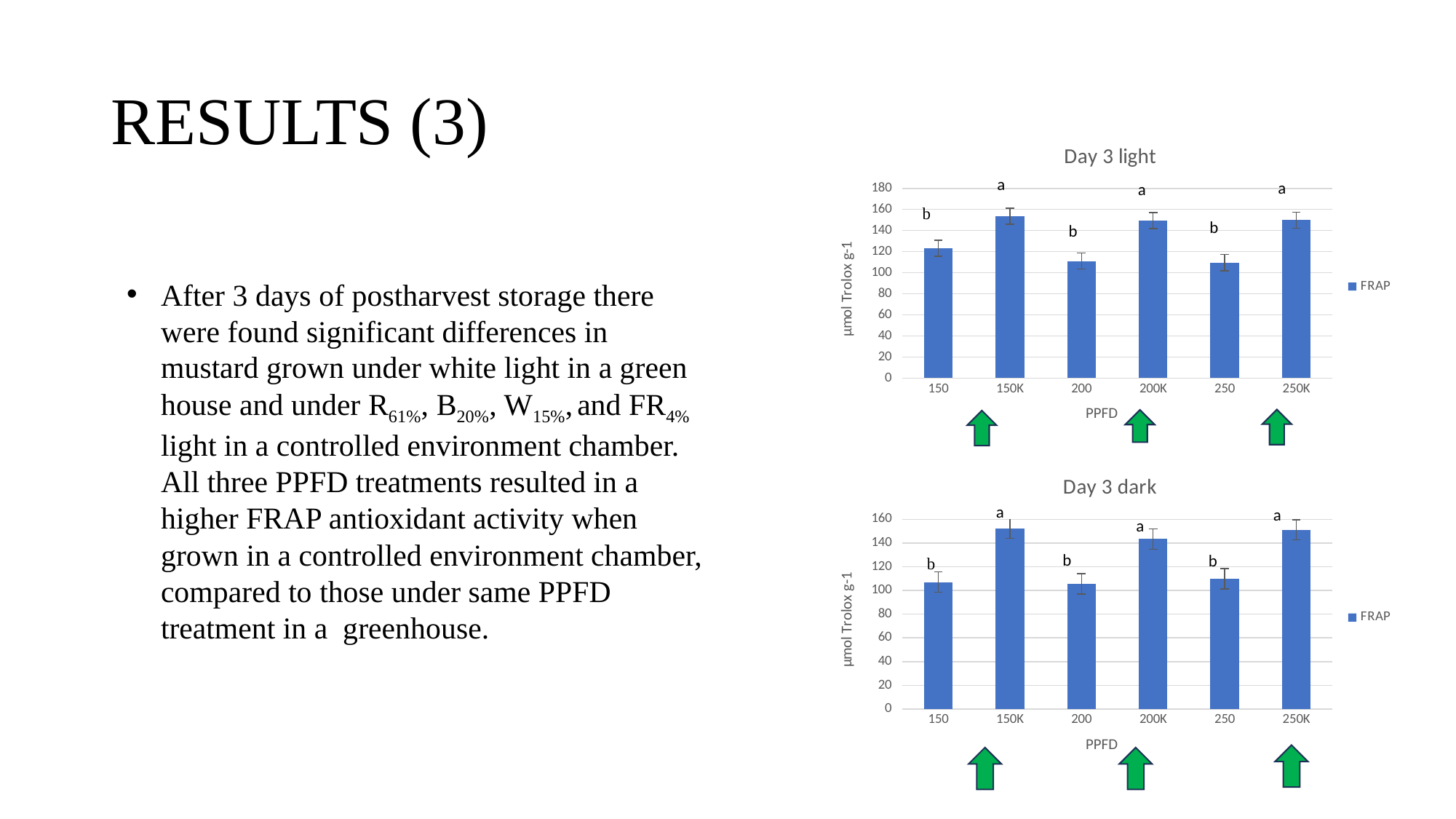
What kind of chart is the "Day 3 light" chart? bar chart How many series does the legend of the "Day 3 light" chart list? 1 What is the y-axis label of the "Day 3 dark" chart? µmol Trolox g-1 In the "Day 3 dark" chart, is the value for 200K greater or less than 120? greater In the "Day 3 light" chart, is the value for 150K greater or less than 140? greater How many categories are shown on the x axis of the "Day 3 dark" chart? 6 What is the x-axis label of the "Day 3 light" chart? PPFD In the "Day 3 light" chart, is the value for 250 greater or less than 100? greater In the "Day 3 dark" chart, which is larger, the value for 200 or the value for 200K? 200K In the "Day 3 light" chart, which is larger, the value for 150 or the value for 150K? 150K